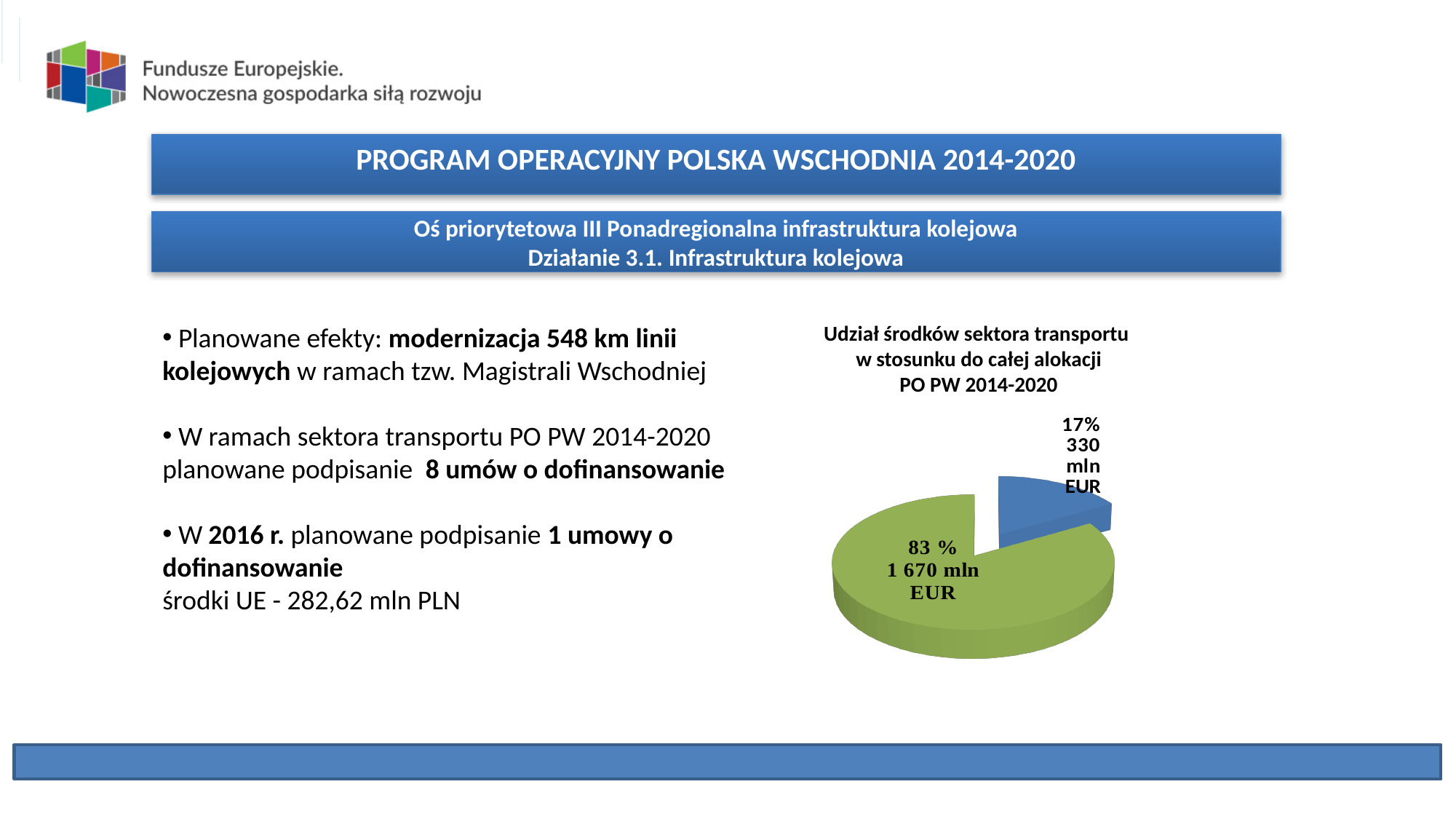
What is the difference in percentage points between the green slice and the blue slice? 66 What kind of chart is shown on the slide? pie chart What value in mln EUR is labelled on the green slice of the pie chart? 1 670 mln EUR By how many mln EUR does the green slice exceed the blue slice? 1 340 mln EUR What share of the pie does the green slice represent? 83 % Which slice of the pie chart is larger, the blue one or the green one? the green one What is the title of the pie chart? Udział środków sektora transportu w stosunku do całej alokacji PO PW 2014-2020 What is the total in mln EUR of the two slices of the pie chart? 2 000 mln EUR How many slices does the pie chart have? 2 Which slice of the pie chart is the smallest? the blue slice (17%) What share of the pie does the blue slice represent? 17% What value in mln EUR is labelled on the blue slice of the pie chart? 330 mln EUR